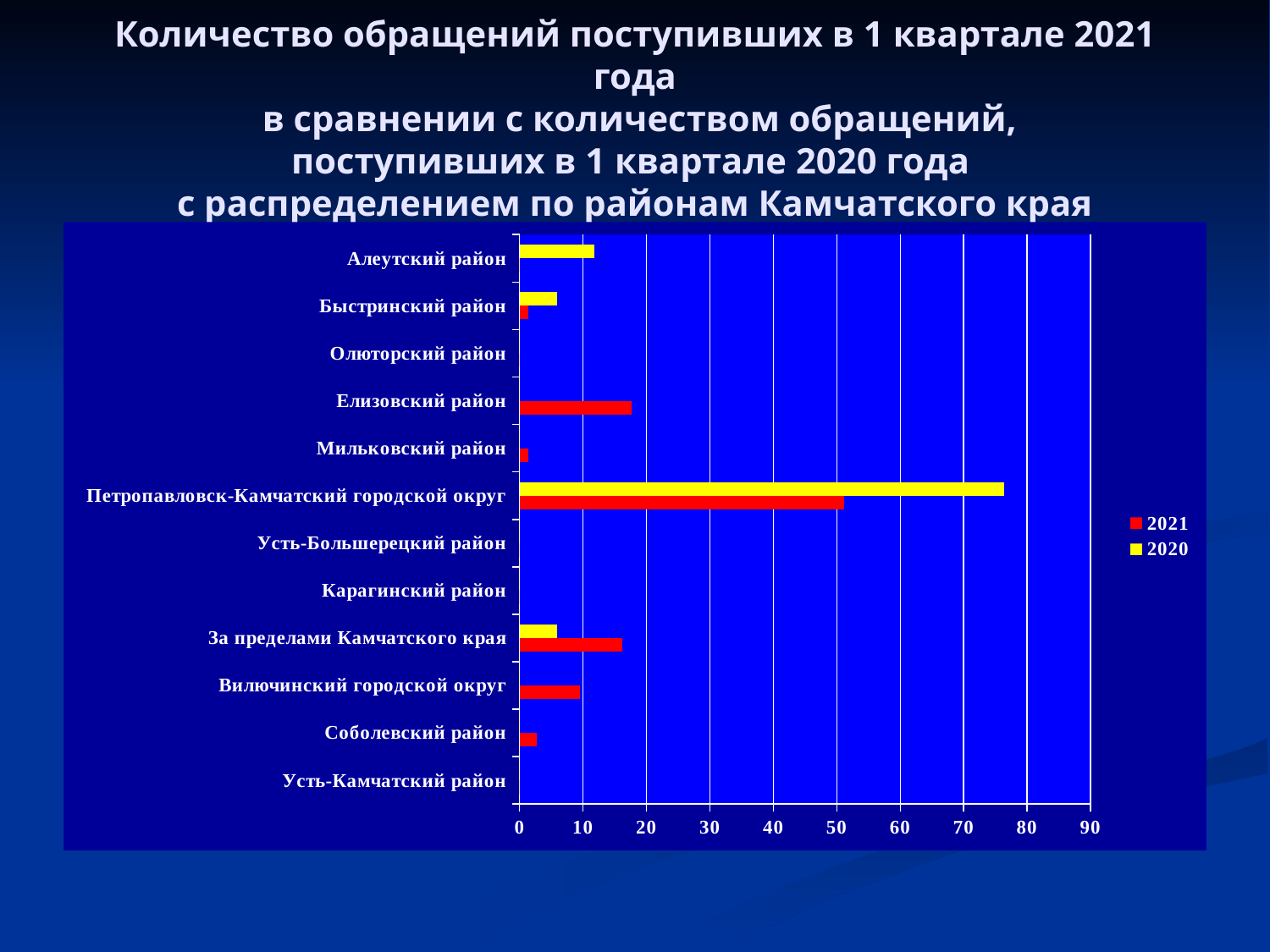
For За пределами Камчатского края, which series has the larger value, 2020 or 2021? 2021 Which district has the highest value for the 2021 series? Петропавловск-Камчатский городской округ Is the 2021 value for Петропавловск-Камчатский городской округ greater or less than 40? greater How many districts (categories) are listed on the vertical axis of the chart? 12 What kind of chart is shown on the slide? bar chart Is the 2020 value for Петропавловск-Камчатский городской округ greater or less than 70? greater How many series does the legend list? 2 Which district has the highest value for the 2020 series? Петропавловск-Камчатский городской округ Is the 2021 value for Елизовский район greater or less than 10? greater Which colour represents the 2020 series in the legend? yellow Which has the larger 2021 value, Елизовский район or Соболевский район? Елизовский район For Петропавловск-Камчатский городской округ, which series has the larger value, 2020 or 2021? 2020